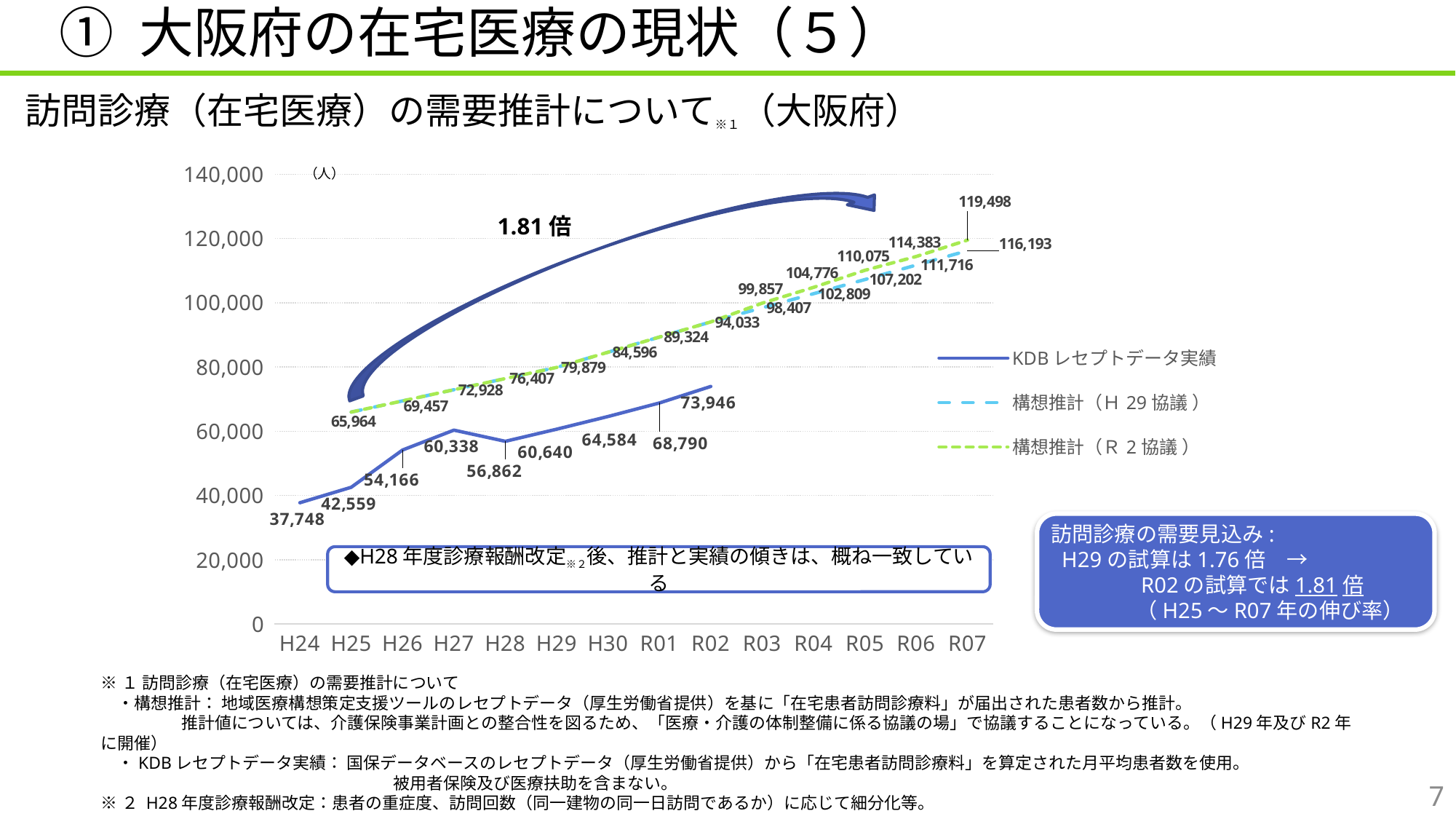
Which is larger, the KDBレセプトデータ実績 value for H27 or for H28? H27 What is the 構想推計（H29協議） value for R07? 116,193 How many year categories are shown on the x axis of the chart? 14 How many series does the chart legend list? 3 What is the KDBレセプトデータ実績 value for H24? 37,748 What is the KDBレセプトデータ実績 value for R02? 73,946 What type of chart is shown on the slide? line chart By how much did the KDBレセプトデータ実績 value increase from H24 to R02? 36,198 What growth multiplier is written next to the large arrow on the chart? 1.81倍 In which year is the KDBレセプトデータ実績 value lowest? H24 What is the 構想推計（R2協議） value for R07? 119,498 What is the difference between the 構想推計（R2協議） and 構想推計（H29協議） values for R07? 3,305